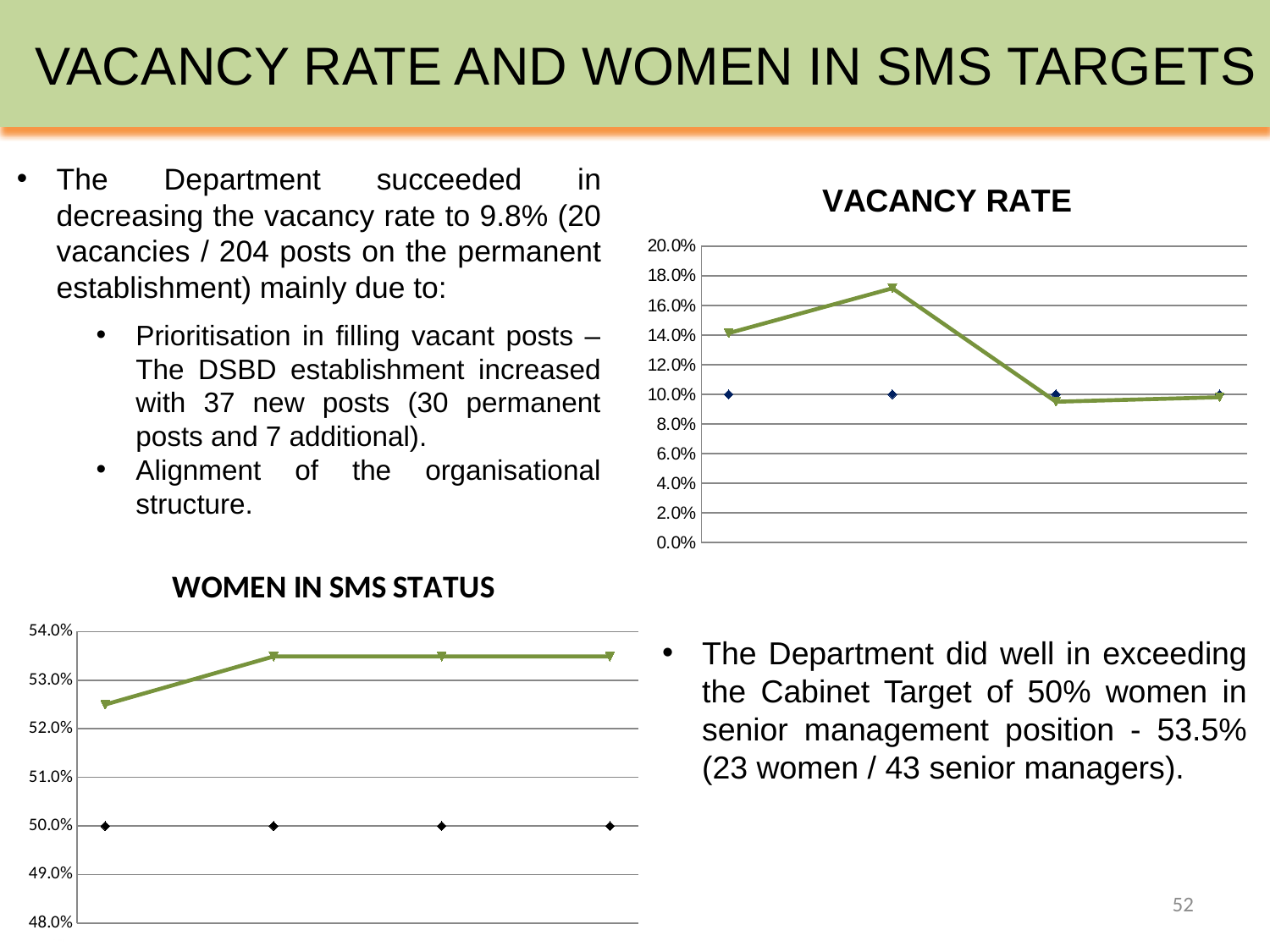
In the VACANCY RATE chart, is the second point of the green line greater or less than 16.0%? greater In the WOMEN IN SMS STATUS chart, how many data points does each line have? 4 In the VACANCY RATE chart, what value does the flat blue diamond line sit at? 10.0% In the VACANCY RATE chart, is the third point of the green line greater or less than 12.0%? less In the WOMEN IN SMS STATUS chart, is the first point of the green line greater or less than 52.0%? greater In the VACANCY RATE chart, does the green line end higher or lower than it starts? Lower In the VACANCY RATE chart, how many data points does each line have? 4 What kind of chart is the WOMEN IN SMS STATUS chart? Line chart In the WOMEN IN SMS STATUS chart, does the green line rise or fall from the first point to the second point? Rise In the WOMEN IN SMS STATUS chart, what value does the flat black diamond line sit at? 50.0% What kind of chart is the VACANCY RATE chart? Line chart